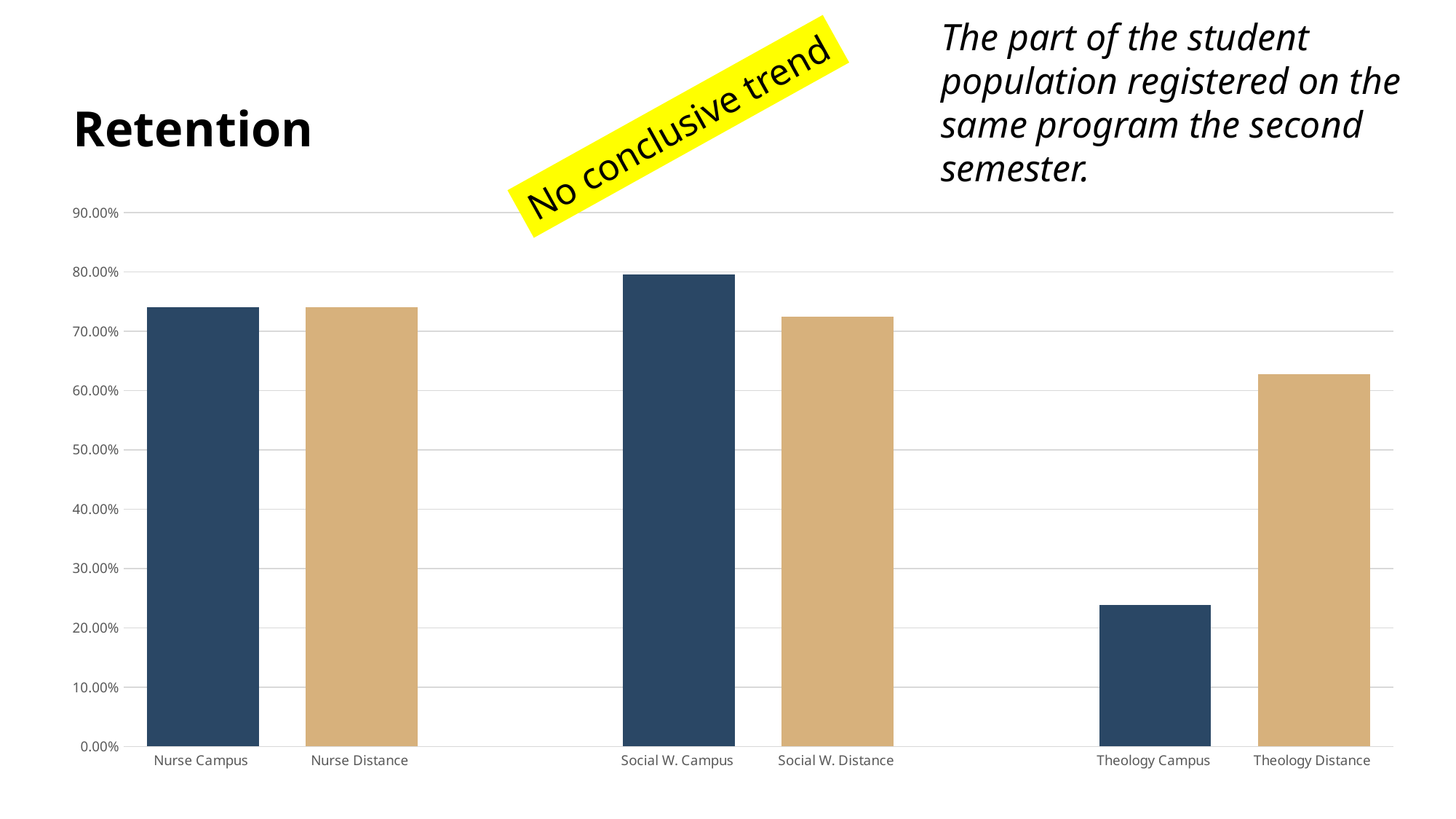
Is the value for Nurse Campus greater or less than 70.00%? greater Is the value for Theology Distance greater or less than 60.00%? greater Is the value for Social W. Campus greater or less than 70.00%? greater What kind of chart is shown on the slide? bar chart What colour are the bars for the Campus categories? dark blue Which category has the lowest retention value? Theology Campus Which is larger, the value for Theology Campus or Theology Distance? Theology Distance Which category has the highest retention value? Social W. Campus How many categories (bars) does the chart show? 6 Which is larger, the value for Social W. Campus or Social W. Distance? Social W. Campus What is the title of the chart? Retention